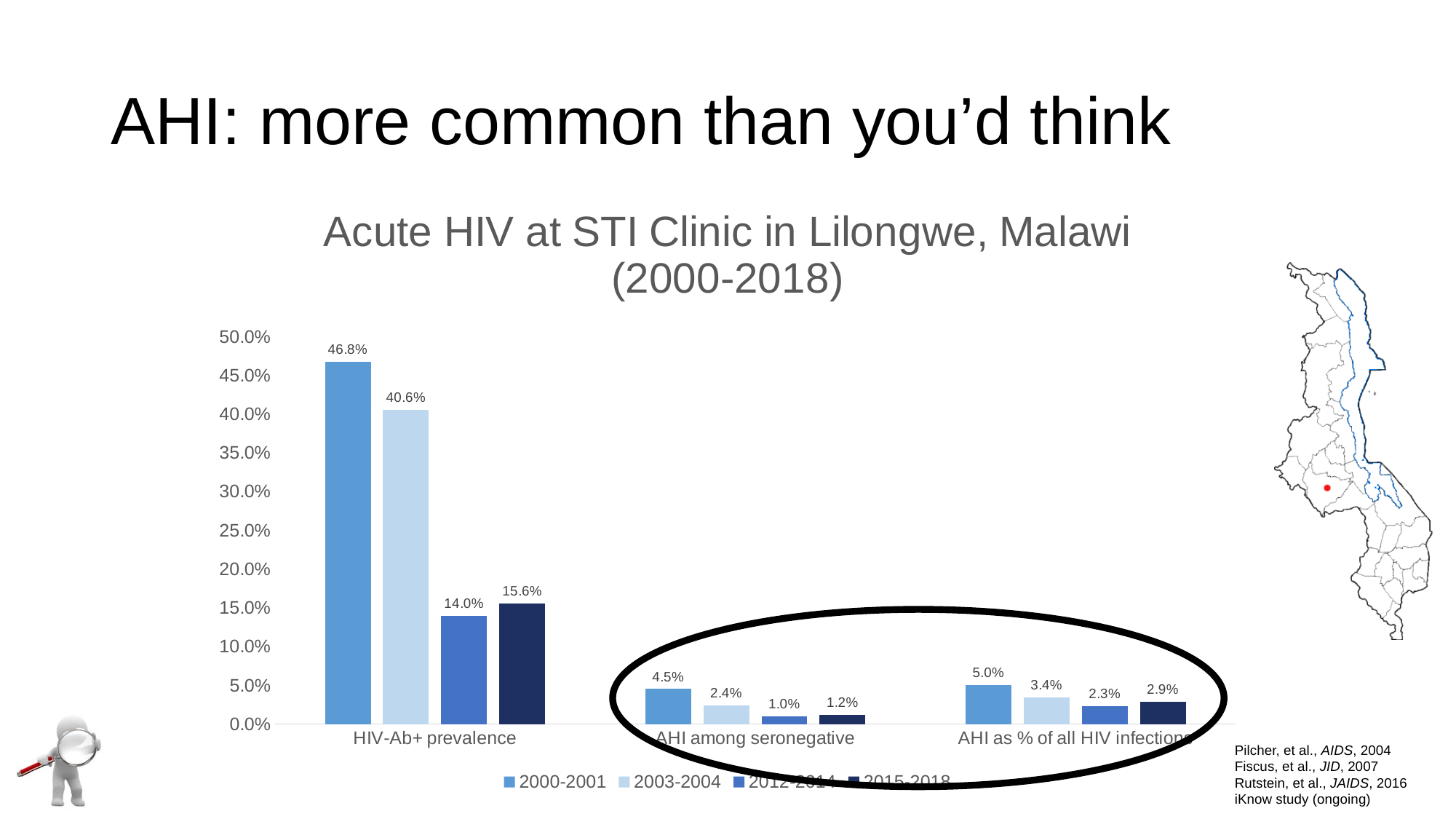
What is the difference between the 2000-2001 and 2003-2004 values for HIV-Ab+ prevalence? 6.2% Which series has the lowest value in the AHI among seronegative category? 2012-2014 What is the title of the chart? Acute HIV at STI Clinic in Lilongwe, Malawi (2000-2018) What is the value for 2003-2004 in the AHI among seronegative category? 2.4% How many series does the legend list? 4 Which series has the highest value in the HIV-Ab+ prevalence category? 2000-2001 How many categories are shown on the x axis? 3 Which is larger in the AHI as % of all HIV infections category: the 2003-2004 value or the 2015-2018 value? 2003-2004 What kind of chart is shown on the slide? bar chart What is the value for 2000-2001 in the HIV-Ab+ prevalence category? 46.8% What is the value for 2000-2001 in the AHI as % of all HIV infections category? 5.0% Is the 2015-2018 value for HIV-Ab+ prevalence greater or less than 20.0%? less